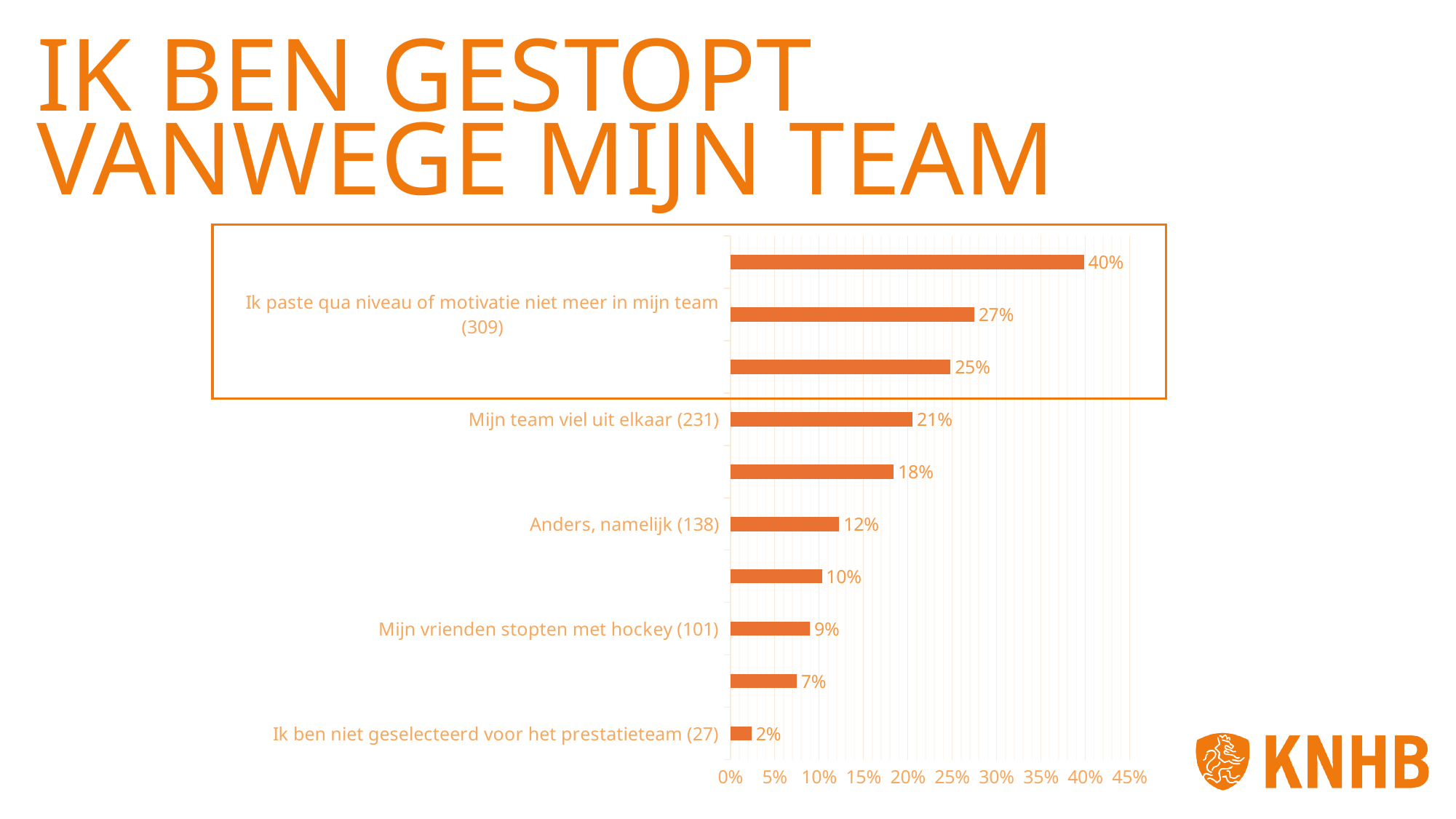
What is the value for "Ik ben niet geselecteerd voor het prestatieteam (27)"? 2% What is the value for "Mijn vrienden stopten met hockey (101)"? 9% What is the value for "Ik paste qua niveau of motivatie niet meer in mijn team (309)"? 27% Which is larger: the value for "Mijn vrienden stopten met hockey (101)" or the value for "Anders, namelijk (138)"? Anders, namelijk (138) What kind of chart is shown on the slide? bar chart Which category has the lowest value in the chart? Ik ben niet geselecteerd voor het prestatieteam (27) What is the highest tick value shown on the horizontal axis? 45% What is the highest value shown in the chart? 40% What is the difference between the values for "Mijn team viel uit elkaar (231)" and "Anders, namelijk (138)"? 9% What is the value for "Mijn team viel uit elkaar (231)"? 21% What is the value for "Anders, namelijk (138)"? 12% How many bars are plotted in the chart? 10